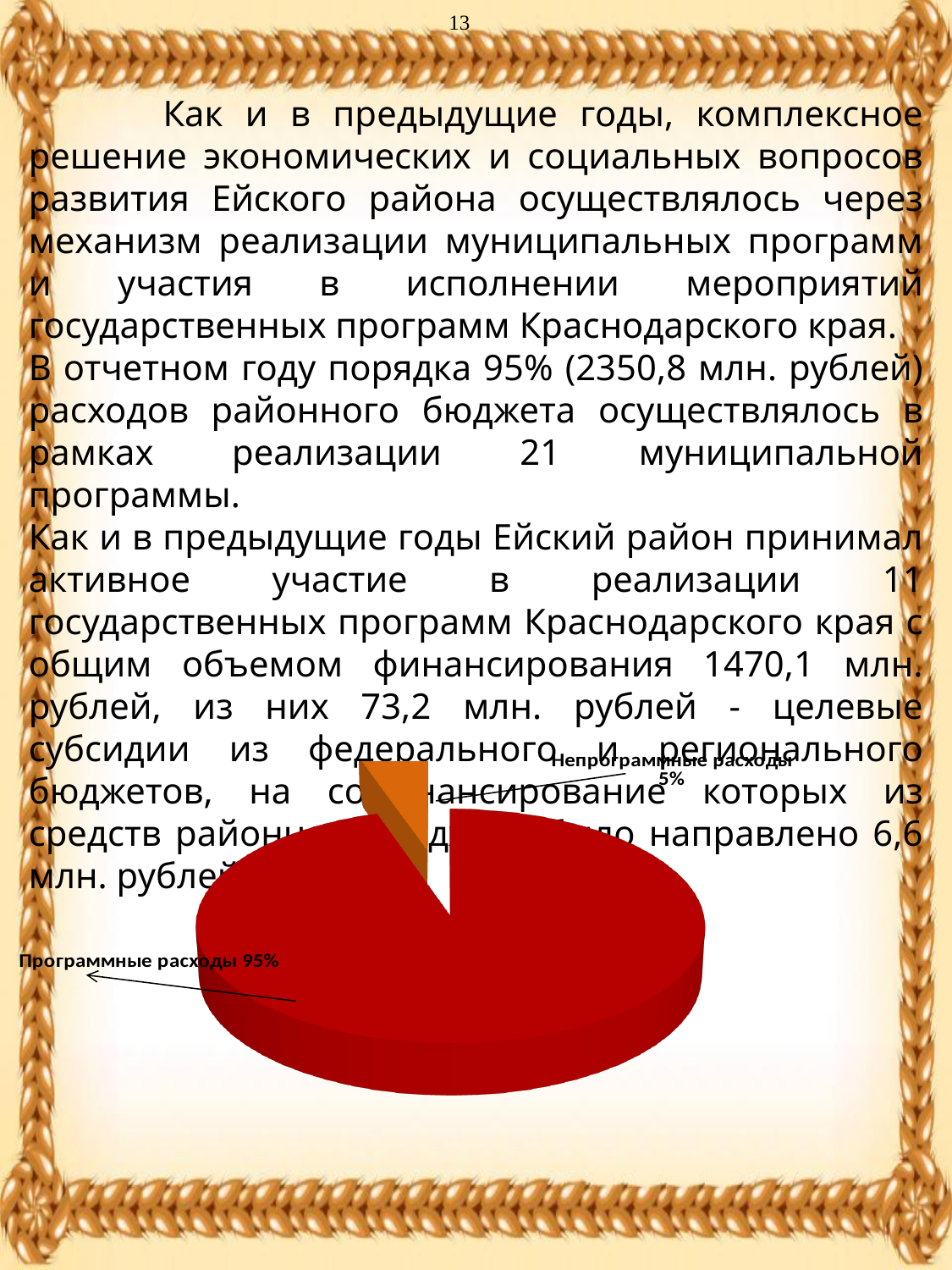
What share of the pie is labelled "Программные расходы"? 95% What kind of chart is shown on the slide? pie chart Which slice of the pie chart is the largest? Программные расходы How many slices does the pie chart have? 2 What share of the pie is labelled "Непрограммные расходы"? 5% What colour is the Программные расходы slice of the pie chart? red Which is larger in the pie chart: Программные расходы or Непрограммные расходы? Программные расходы What is the difference in percentage points between the Программные расходы and Непрограммные расходы slices? 90 Which slice of the pie chart is the smallest? Непрограммные расходы What colour is the Непрограммные расходы slice of the pie chart? orange